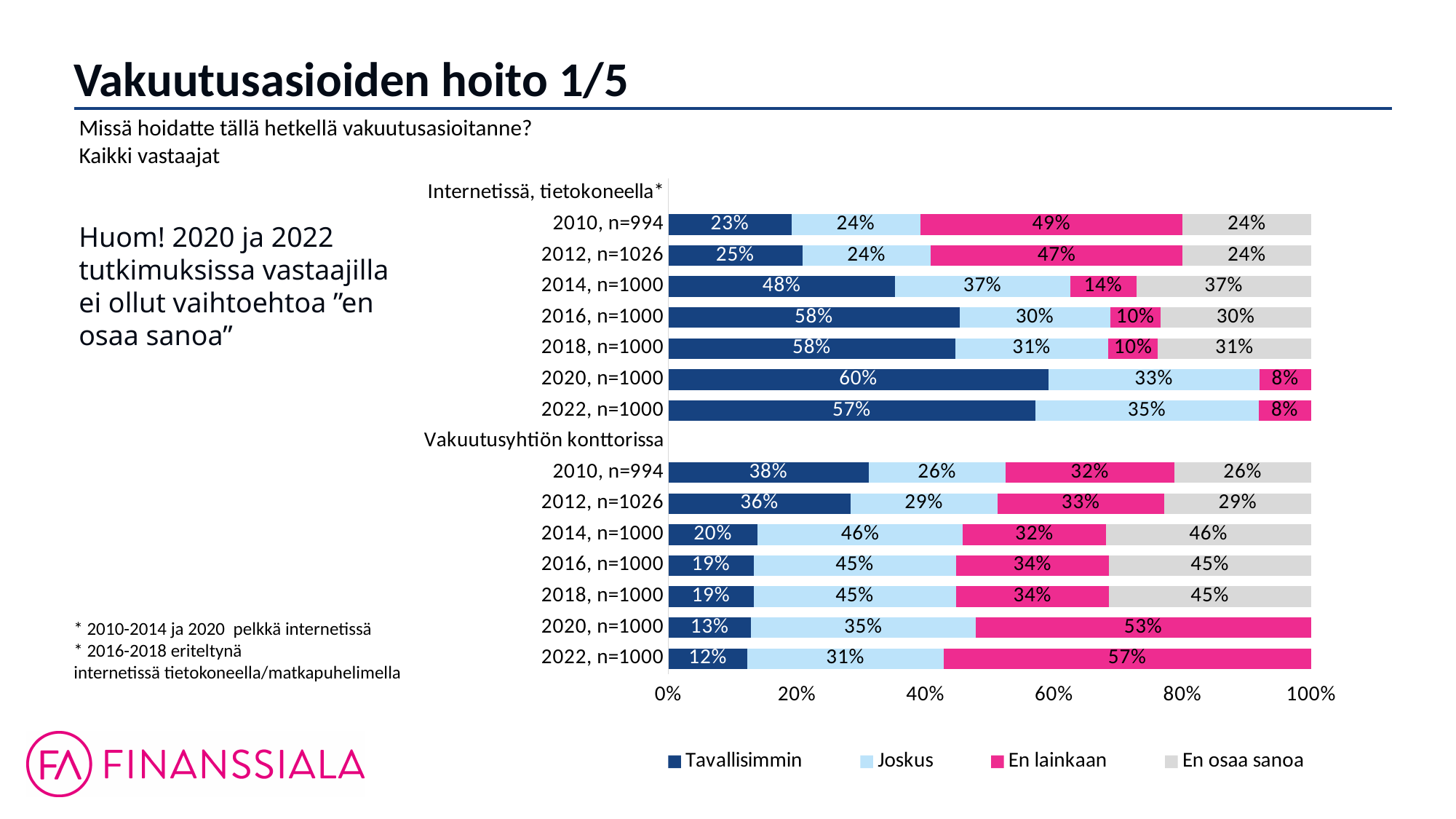
In the 'Vakuutusyhtiön konttorissa' group, which year has the lowest 'Tavallisimmin' value? 2022, n=1000 How many series does the legend list? 4 What is the 'En lainkaan' value for 'Internetissä, tietokoneella' in 2016, n=1000? 10% By how many percentage points did the 'Tavallisimmin' value for 'Internetissä, tietokoneella' change between 2010 and 2022? 34 percentage points Which is larger: the 'En lainkaan' value for 'Vakuutusyhtiön konttorissa' in 2020 or for 'Internetissä, tietokoneella' in 2010? Vakuutusyhtiön konttorissa 2020 How many year rows are shown in the 'Internetissä, tietokoneella' group? 7 What is the 'Tavallisimmin' value for 'Internetissä, tietokoneella' in 2020, n=1000? 60% What is the 'En lainkaan' value for 'Vakuutusyhtiön konttorissa' in 2022, n=1000? 57% Does the 'Tavallisimmin' value for 'Internetissä, tietokoneella' rise or fall from 2010 to 2020? Rise What kind of chart is shown on the slide? Stacked bar chart In the 'Internetissä, tietokoneella' group, which year has the highest 'Tavallisimmin' value? 2020, n=1000 What is the 'Joskus' value for 'Internetissä, tietokoneella' in 2014, n=1000? 37%